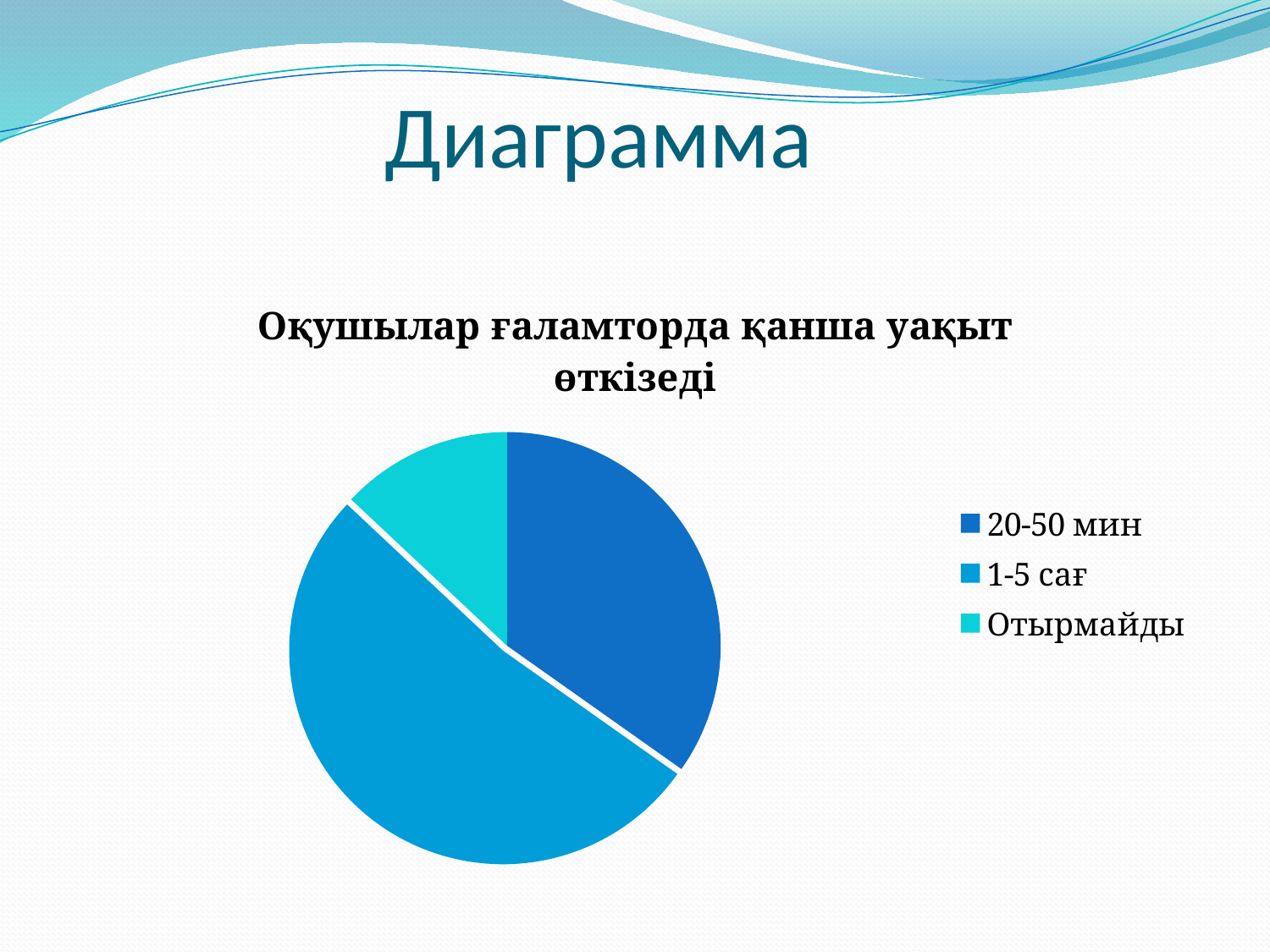
Which slice is larger, "20-50 мин" or "Отырмайды"? 20-50 мин Which slice is larger, "1-5 сағ" or "Отырмайды"? 1-5 сағ How many entries does the legend list? 3 Which category has the smallest slice of the pie? Отырмайды What is the title of the chart? Оқушылар ғаламторда қанша уақыт өткізеді How many slices does the pie chart have? 3 What kind of chart is shown on the slide? pie chart What colour is the "Отырмайды" slice? cyan (light turquoise) Which category has the largest slice of the pie? 1-5 сағ